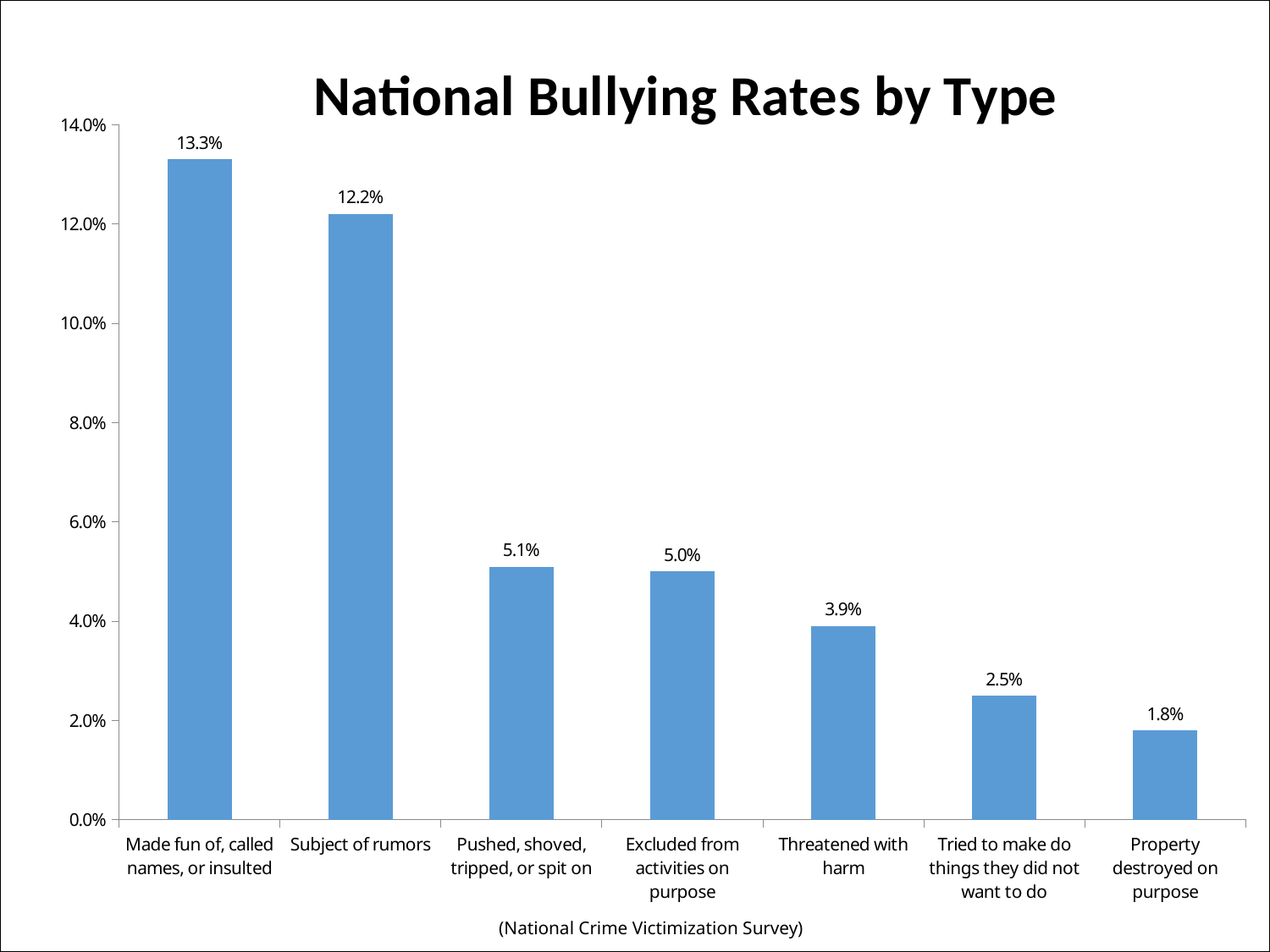
What is the difference between the rates for "Made fun of, called names, or insulted" and "Subject of rumors"? 1.1% What is the rate for "Threatened with harm"? 3.9% What kind of chart is shown on the slide? Bar chart Which type of bullying has the highest rate? Made fun of, called names, or insulted How many types of bullying are shown in the chart? 7 Which has a higher rate: "Pushed, shoved, tripped, or spit on" or "Threatened with harm"? Pushed, shoved, tripped, or spit on What is the rate for "Property destroyed on purpose"? 1.8% What is the national bullying rate for "Subject of rumors"? 12.2% What is the title of the chart? National Bullying Rates by Type Which type of bullying has the lowest rate? Property destroyed on purpose What is the difference between the rates for "Excluded from activities on purpose" and "Tried to make do things they did not want to do"? 2.5% Is the rate for "Tried to make do things they did not want to do" greater or less than 4.0%? less